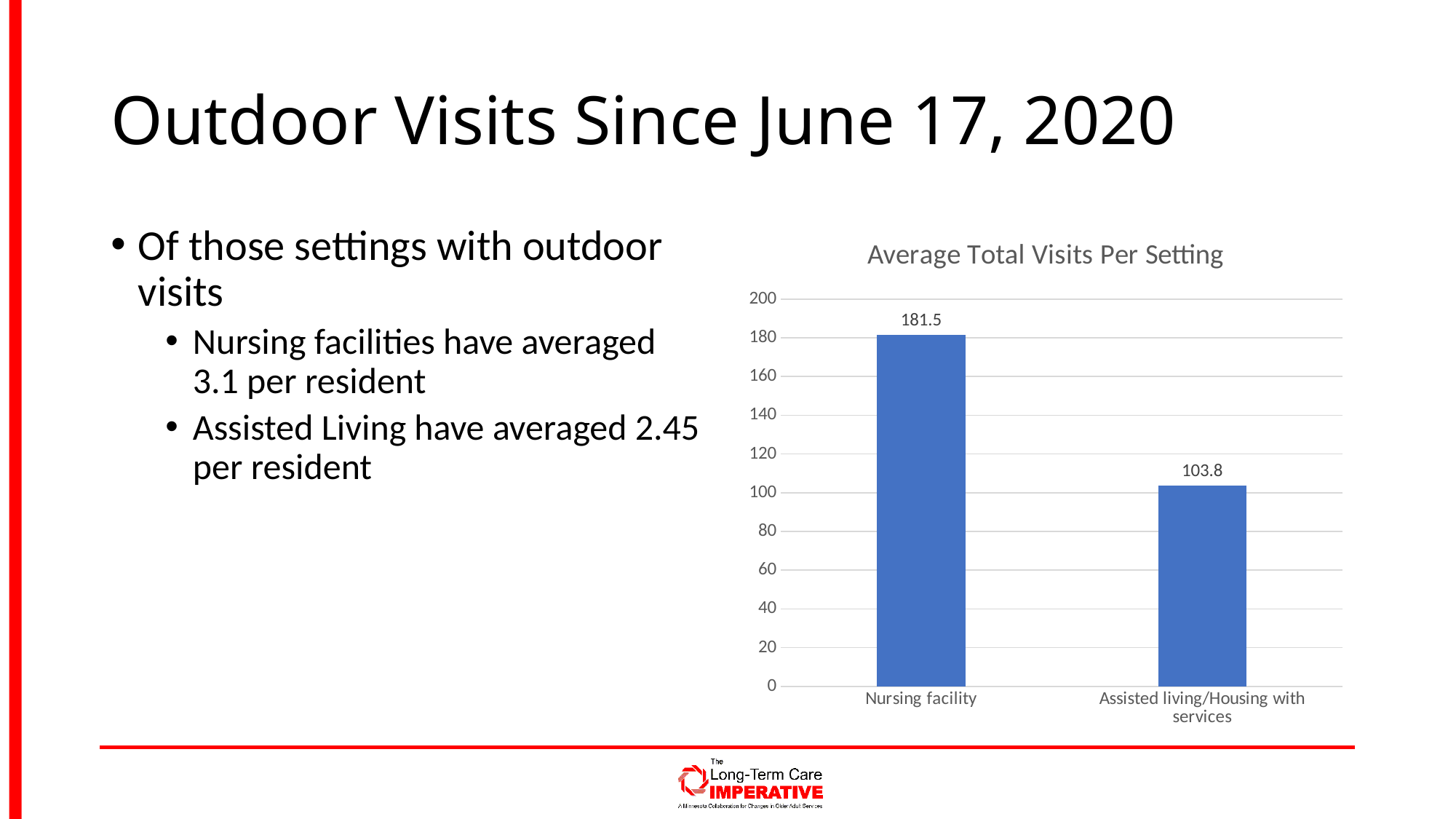
Which setting has the lowest average total visits? Assisted living/Housing with services What kind of chart is shown on the slide? Bar chart Is the value for Nursing facility greater or less than 160? greater What is the average total visits per setting for Nursing facility? 181.5 What is the title of the chart? Average Total Visits Per Setting What is the difference in average total visits between Nursing facility and Assisted living/Housing with services? 77.7 What is the average total visits per setting for Assisted living/Housing with services? 103.8 Which has more average total visits, Nursing facility or Assisted living/Housing with services? Nursing facility How many categories are shown in the chart? 2 Which setting has the highest average total visits? Nursing facility What is the maximum value shown on the chart's vertical axis? 200 Is the value for Assisted living/Housing with services greater or less than 120? less